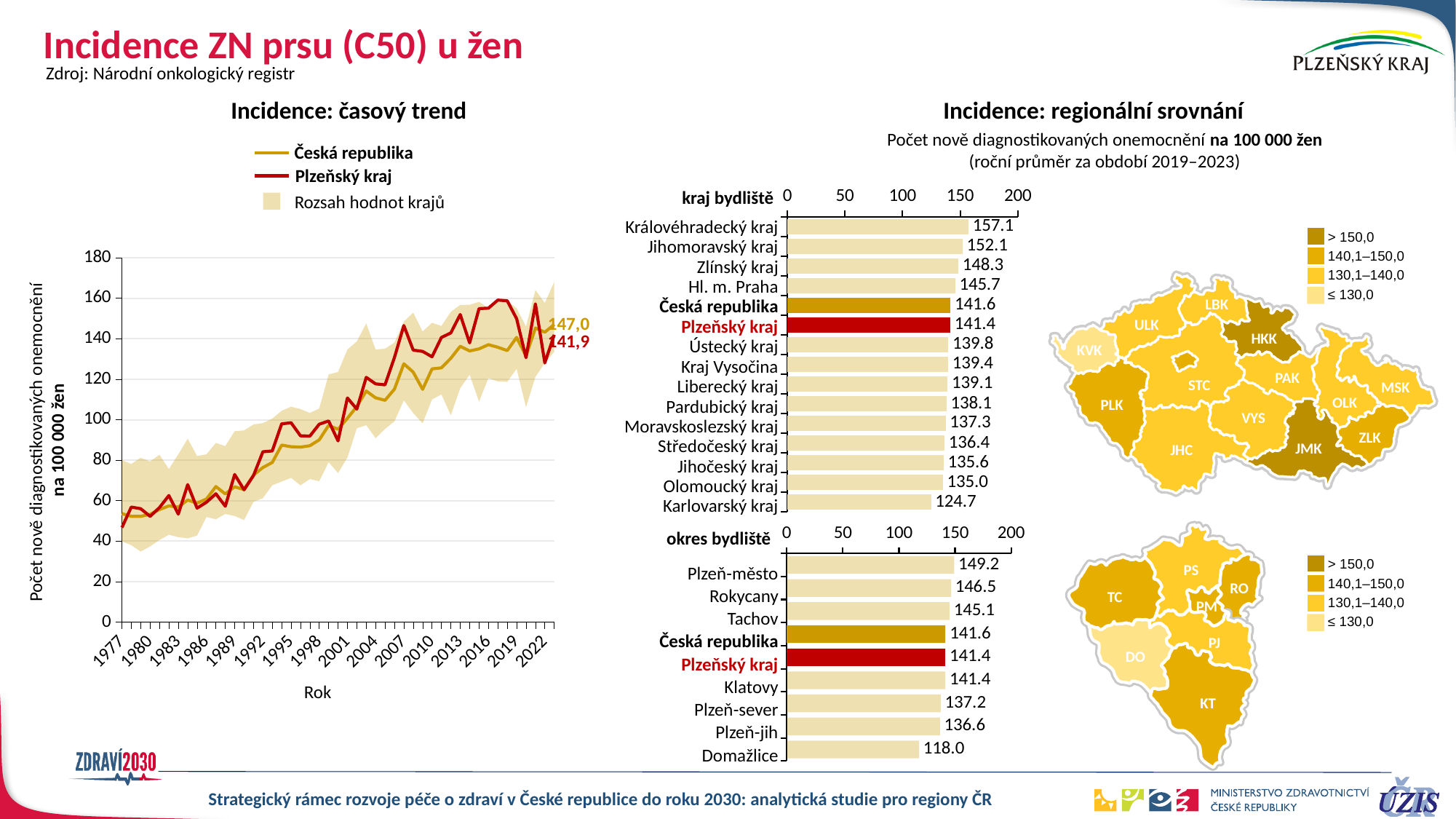
In the 'kraj bydliště' bar chart, which is larger: Zlínský kraj or Hl. m. Praha? Zlínský kraj How many bars are shown in the 'okres bydliště' bar chart? 9 In the 'okres bydliště' bar chart, what is the difference between Plzeň-město and Domažlice? 31.2 In the 'kraj bydliště' bar chart, what is the value for Plzeňský kraj? 141.4 In the 'kraj bydliště' bar chart, what is the value for Královéhradecký kraj? 157.1 In the 'okres bydliště' bar chart, which district has the highest value? Plzeň-město In the 'kraj bydliště' bar chart, which region has the lowest value? Karlovarský kraj In the 'Incidence: časový trend' chart, what is the final labelled value for Plzeňský kraj? 141,9 In the 'Incidence: časový trend' chart, what is the final labelled value for Česká republika? 147,0 In the 'Incidence: časový trend' chart, do the values generally rise or fall from 1977 to 2022? rise In the 'okres bydliště' bar chart, what is the value for Domažlice? 118.0 In the 'kraj bydliště' bar chart, what is the difference between Královéhradecký kraj and Karlovarský kraj? 32.4